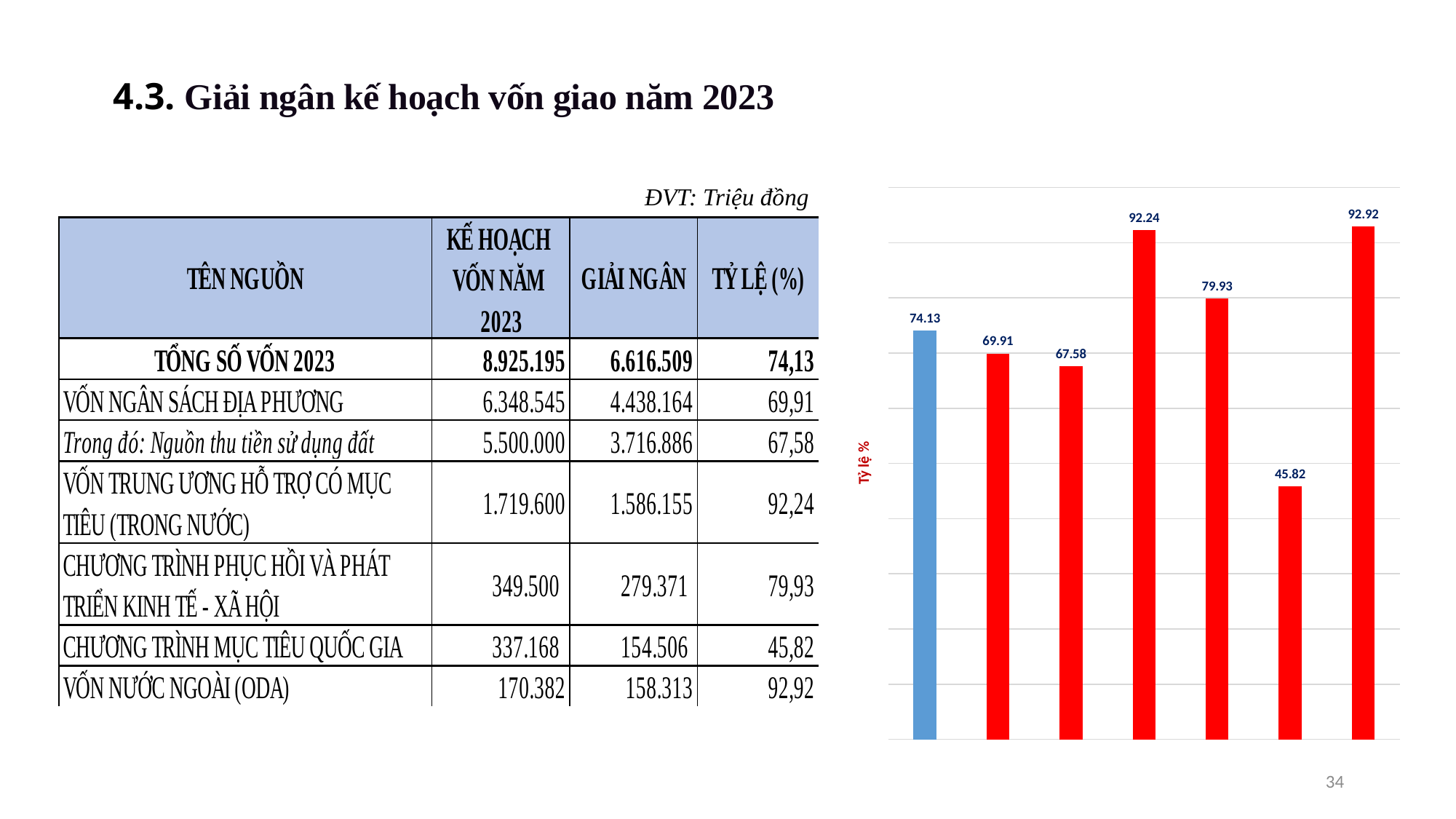
What type of chart is shown on the right side of the slide? bar chart Which is larger in the chart: the fifth bar (79.93) or the third bar (67.58)? The fifth bar (79.93) What is the value labelled on the fourth bar of the chart? 92.24 What is the value labelled on the first (blue) bar of the chart? 74.13 What is the difference between the fourth bar (92.24) and the second bar (69.91) in the chart? 22.33 Which bar in the chart has the highest value, and what is it? The seventh (last) bar, 92.92 What colour is the first bar in the chart, compared with the other bars? Blue; the others are red How many bars are plotted in the chart on the right? 7 What is the title of the vertical axis of the chart? Tỷ lệ % What is the lowest value labelled in the chart? 45.82 What is the value labelled on the sixth bar of the chart? 45.82 What is the difference between the highest bar (92.92) and the lowest bar (45.82) in the chart? 47.10